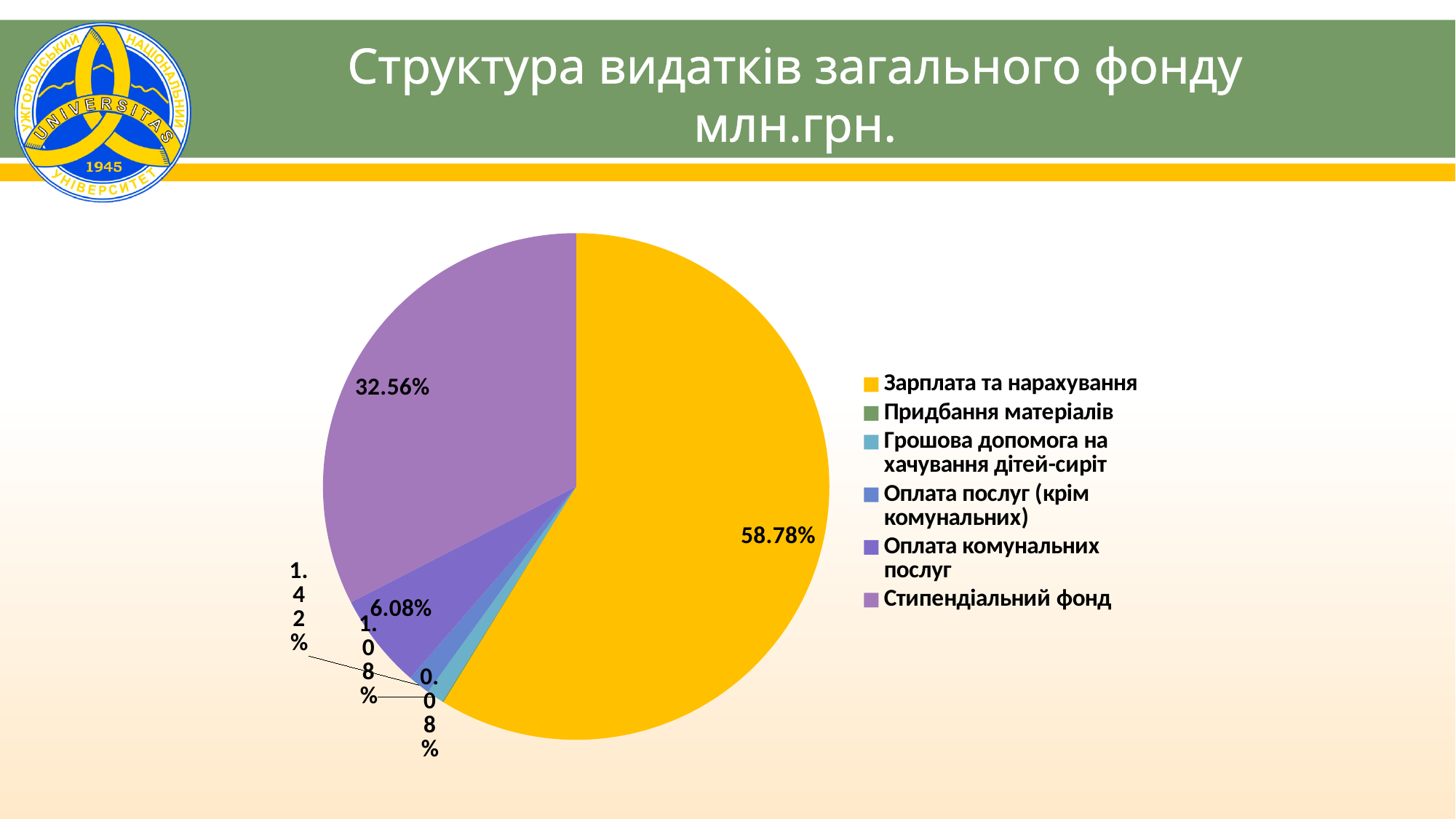
What share of the pie does Зарплата та нарахування represent? 58.78% What is the title of the chart on the slide? Структура видатків загального фонду млн.грн. Which is larger: the share of Стипендіальний фонд or the share of Оплата комунальних послуг? Стипендіальний фонд What kind of chart is shown on the slide? Pie chart What is the smallest percentage labelled on the pie chart? 0.08% How many categories does the pie chart have? 6 How many entries does the legend list? 6 What colour is the slice for Зарплата та нарахування? Yellow What is the value shown for Стипендіальний фонд? 32.56% Which category has the largest slice of the pie? Зарплата та нарахування What is the difference between the shares of Зарплата та нарахування and Стипендіальний фонд? 26.22% What is the value shown for Оплата комунальних послуг? 6.08%